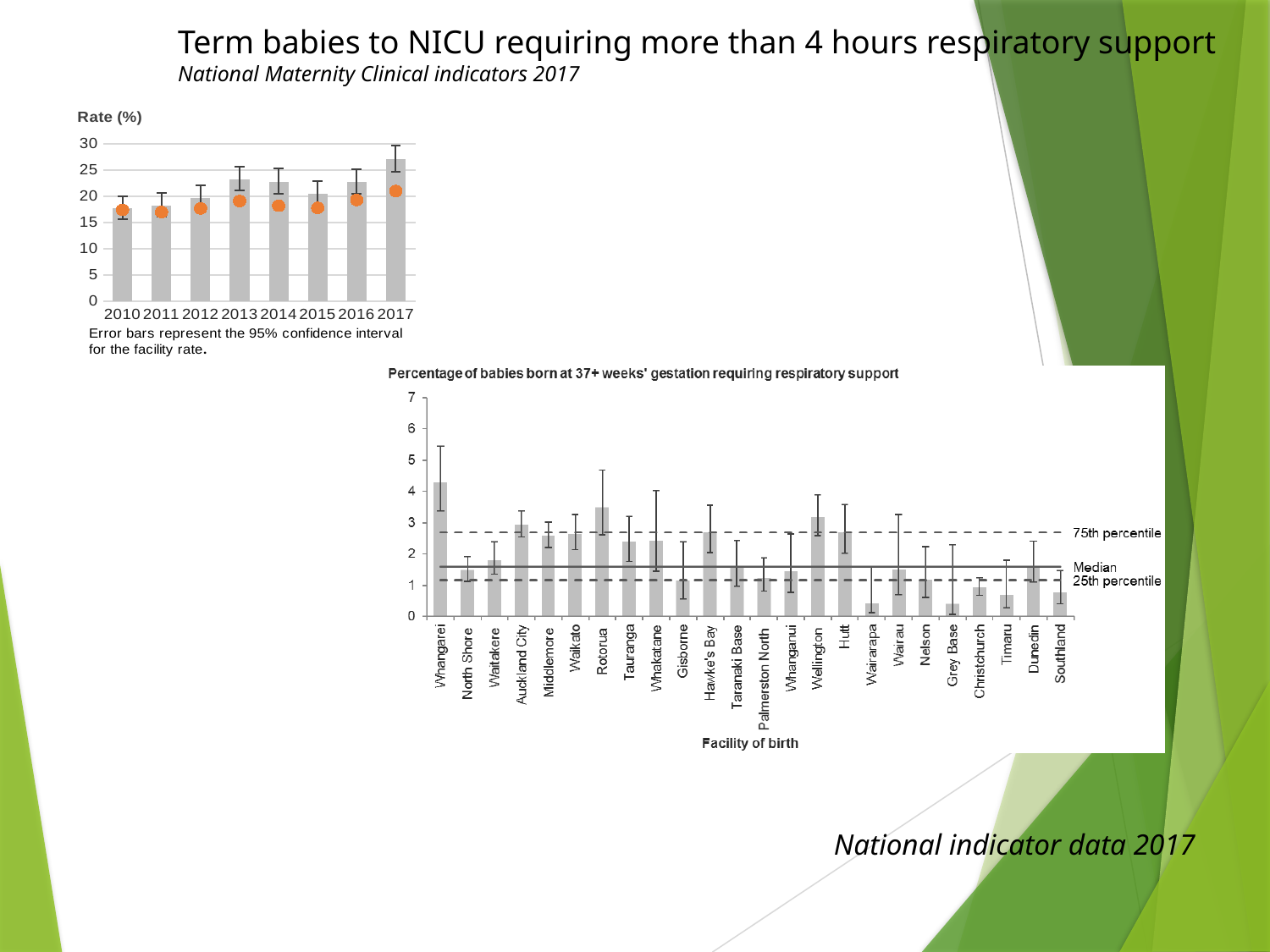
In the top-left 'Rate (%)' chart, how many years are shown on the x axis? 8 In the chart 'Percentage of babies born at 37+ weeks' gestation requiring respiratory support', what is the x-axis title? Facility of birth In the chart 'Percentage of babies born at 37+ weeks' gestation requiring respiratory support', is the value for Whangarei greater or less than 4? greater In the top-left 'Rate (%)' chart, is the value for 2010 greater or less than 20? less In the top-left 'Rate (%)' chart, do the bar values generally rise or fall from 2010 to 2017? rise In the top-left 'Rate (%)' chart, which year has the highest bar? 2017 In the chart 'Percentage of babies born at 37+ weeks' gestation requiring respiratory support', which is larger, the value for Auckland City or the value for North Shore? Auckland City In the top-left 'Rate (%)' chart, what do the error bars represent according to the note below it? the 95% confidence interval for the facility rate What kind of chart is the top-left chart labelled 'Rate (%)'? bar chart In the top-left 'Rate (%)' chart, is the value for 2017 greater or less than 25? greater In the chart 'Percentage of babies born at 37+ weeks' gestation requiring respiratory support', which facility has the highest bar? Whangarei In the chart 'Percentage of babies born at 37+ weeks' gestation requiring respiratory support', how many facilities are shown on the x axis? 24